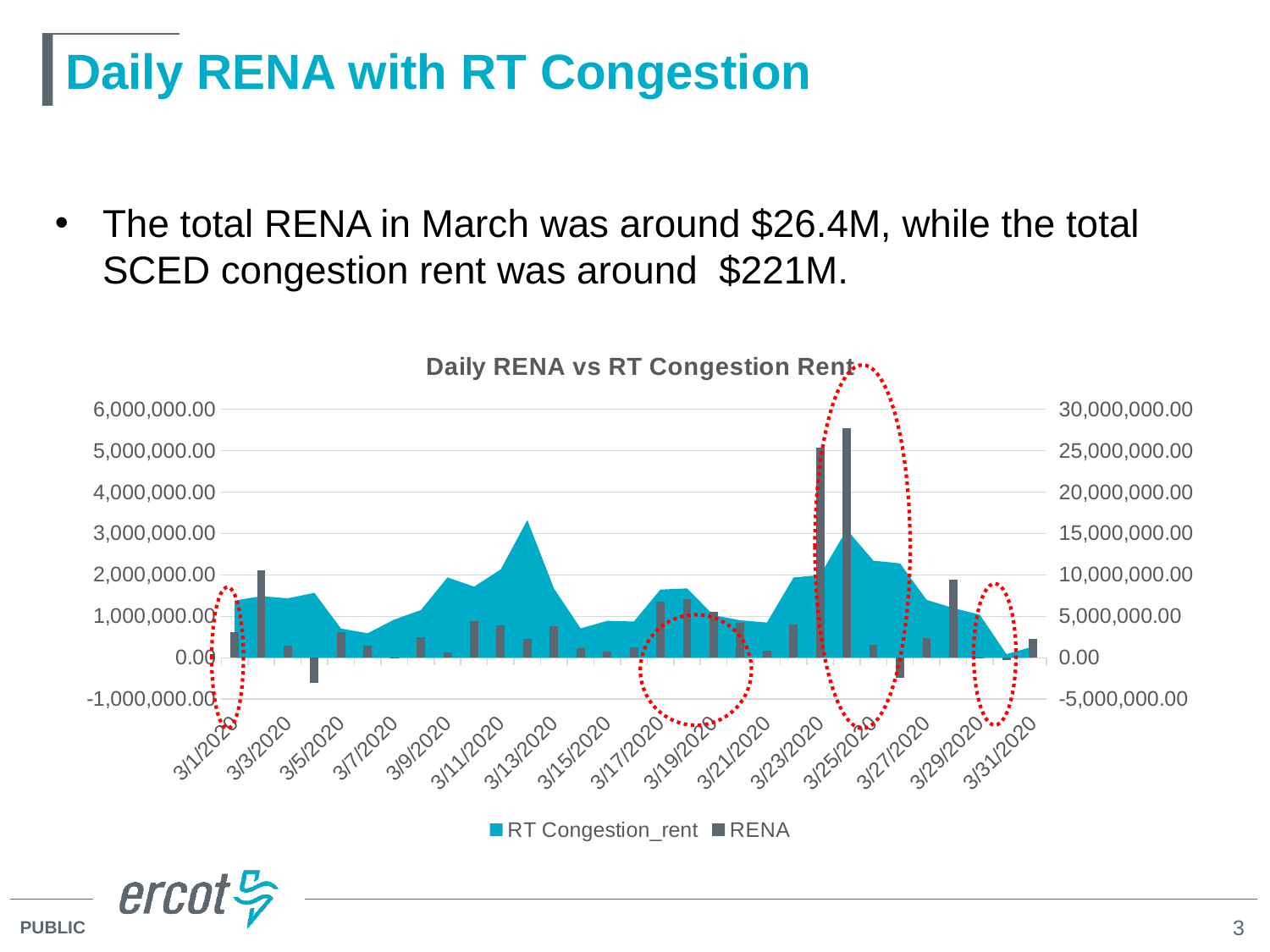
What is the lowest value shown on the right vertical axis of the chart? -5,000,000.00 Does the RT Congestion_rent series rise or fall between 3/25/2020 and 3/31/2020? fall Are there any RENA bars with negative values in the chart? Yes How many series does the chart legend list? 2 What is the highest value shown on the right vertical axis of the chart? 30,000,000.00 How many date labels are shown along the x axis of the chart? 16 What is the highest value shown on the left vertical axis of the chart? 6,000,000.00 Which two series are listed in the chart legend? RT Congestion_rent and RENA What kind of chart is shown on the slide? A combination chart with bars and an area series Is the peak of the RT Congestion_rent area greater or less than 10,000,000.00 on the right axis? greater Is the tallest RENA bar greater or less than 5,000,000.00 on the left axis? greater What is the title of the chart on the slide? Daily RENA vs RT Congestion Rent